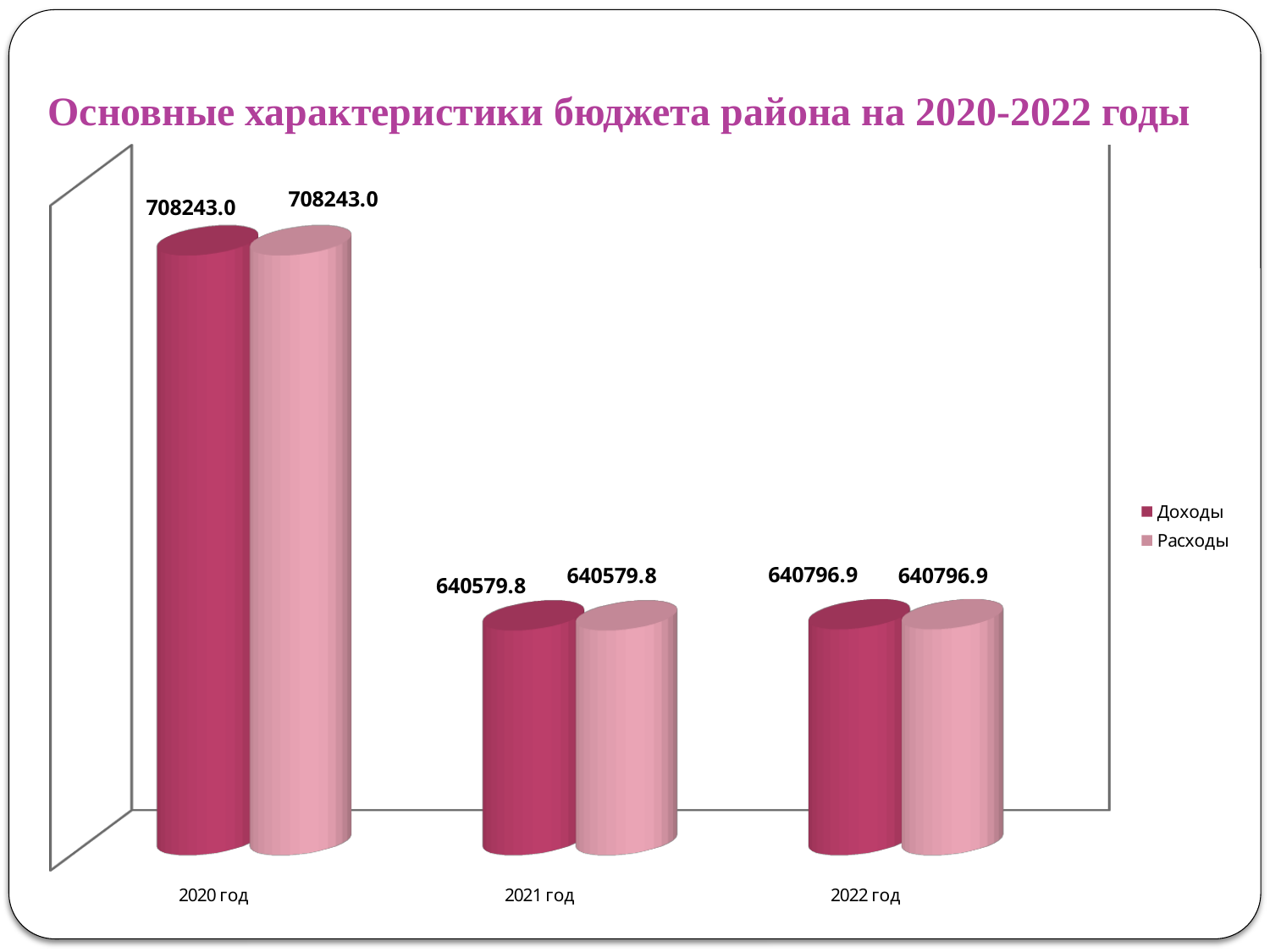
What kind of chart is shown on the slide? bar chart What is the value of Доходы for 2020 год? 708243.0 What is the difference between the Доходы value for 2020 год and for 2021 год? 67663.2 What is the value of Расходы for 2021 год? 640579.8 How many years are shown on the x axis? 3 How many series does the legend list? 2 What is the value of Доходы for 2022 год? 640796.9 What are the two series named in the legend? Доходы and Расходы Which year has the lowest value for Расходы? 2021 год Which year has the highest value for Доходы? 2020 год Do the Доходы values rise or fall from 2020 год to 2021 год? fall Is the Расходы value for 2020 год larger or smaller than the Расходы value for 2022 год? larger